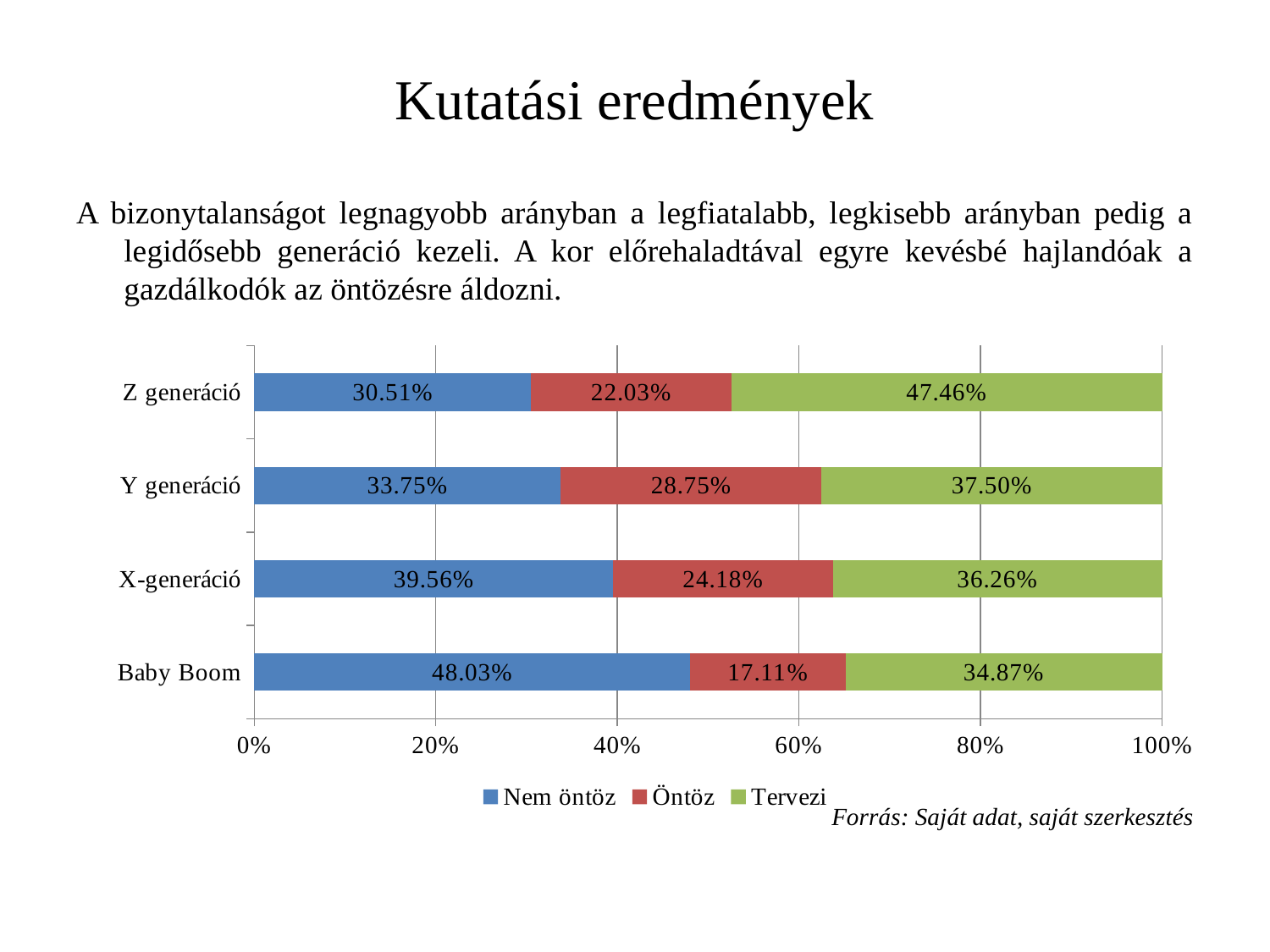
How many generation categories are shown on the chart? 4 What is the difference between the "Nem öntöz" values for Baby Boom and Z generáció? 17.52% Which is larger: the "Tervezi" value for Y generáció or for X-generáció? Y generáció How many series does the legend list? 3 Which generation has the lowest "Öntöz" value? Baby Boom What is the value for "Nem öntöz" for Baby Boom? 48.03% Which generation has the highest "Nem öntöz" value? Baby Boom What is the value for "Öntöz" for X-generáció? 24.18% What is the value for "Tervezi" for Z generáció? 47.46% What kind of chart is shown on the slide? Stacked bar chart What is the value for "Öntöz" for Y generáció? 28.75% Which colour represents the "Tervezi" series? Green